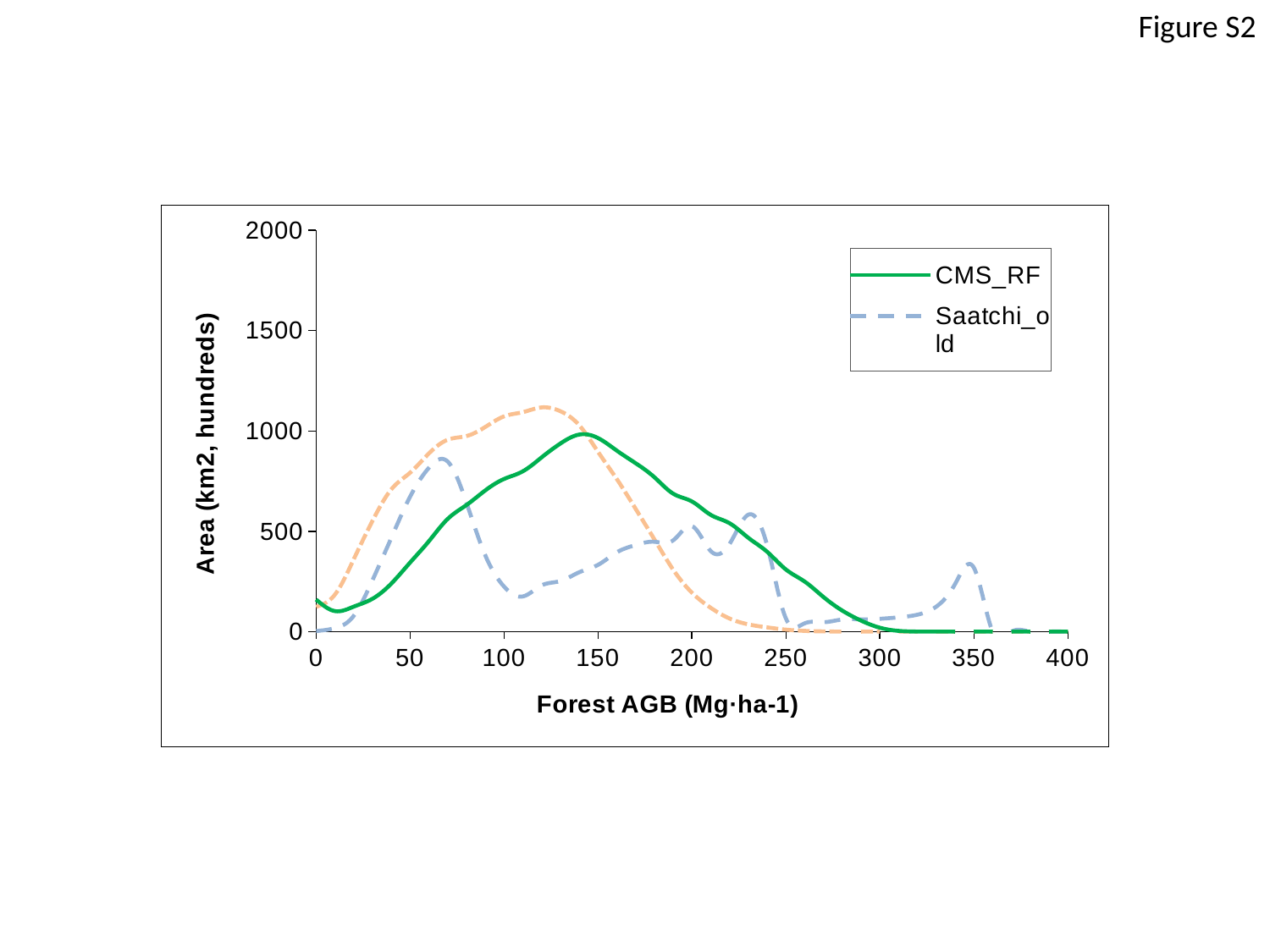
How many series does the legend list? 2 What kind of chart is shown on the slide? line chart At a Forest AGB of 50, which series has the larger value, CMS_RF or Saatchi_old? Saatchi_old Does the CMS_RF line rise or fall as Forest AGB increases from 150 to 300? fall Is the value of CMS_RF at a Forest AGB of 300 greater or less than 500? less Is the value of Saatchi_old at a Forest AGB of 100 greater or less than 500? less Is the value of CMS_RF at a Forest AGB of 100 greater or less than 500? greater Does the CMS_RF line rise or fall as Forest AGB increases from 50 to 150? rise What is the title of the x axis? Forest AGB (Mg·ha-1) At a Forest AGB of 100, which series has the larger value, CMS_RF or Saatchi_old? CMS_RF What is the title of the y axis? Area (km2, hundreds)